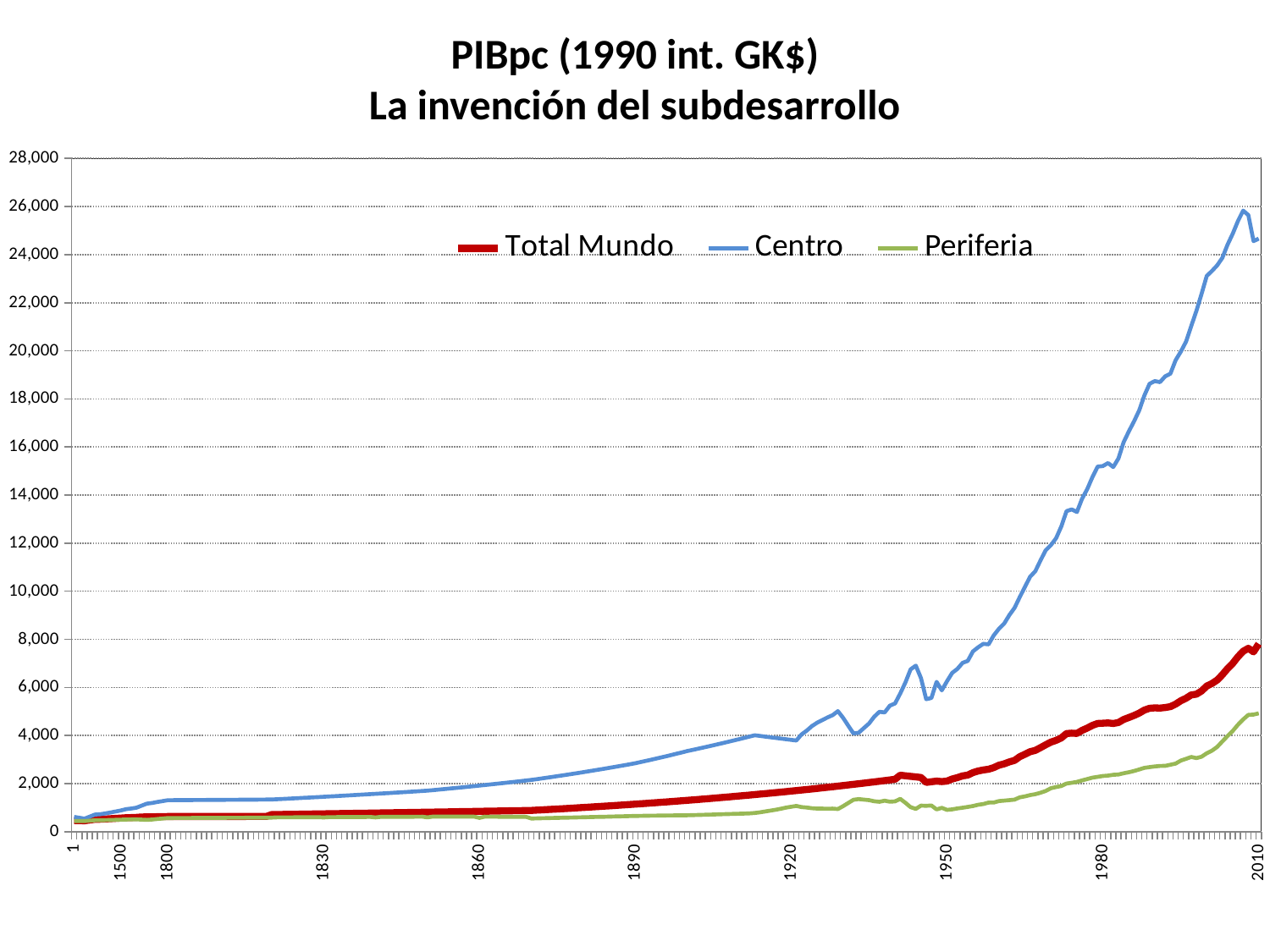
Which series reaches the highest value on the chart? Centro Which series has the lowest value at 2010? Periferia Which series is drawn in red? Total Mundo Is the value for Periferia at 2010 greater or less than 6,000? less At 2010, which is larger: Centro or Periferia? Centro Is the value for Centro at 1920 greater or less than 6,000? less Is the value for Centro at 2010 greater or less than 20,000? greater What is the title of the chart? PIBpc (1990 int. GK$) La invención del subdesarrollo Does the Centro series generally rise or fall from 1950 to 2010? rise How many series does the legend list? 3 What kind of chart is shown on the slide? line chart